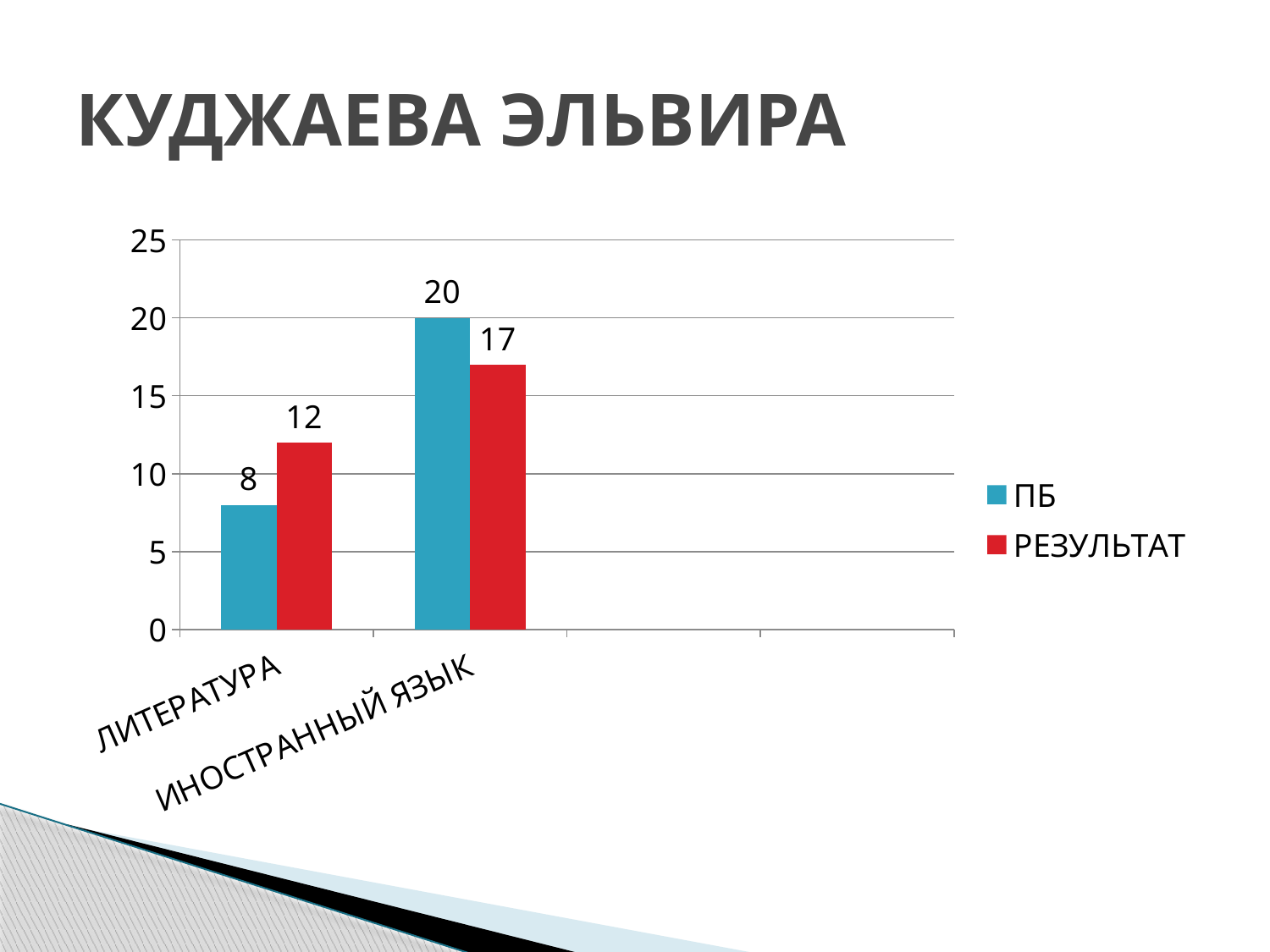
What is the РЕЗУЛЬТАТ value for ЛИТЕРАТУРА? 12 What is the ПБ value for ИНОСТРАННЫЙ ЯЗЫК? 20 How many categories are shown on the x axis? 2 What kind of chart is shown on the slide? Bar chart What is the difference between the ПБ and РЕЗУЛЬТАТ values for ИНОСТРАННЫЙ ЯЗЫК? 3 How many series does the legend list? 2 Which category has the highest ПБ value? ИНОСТРАННЫЙ ЯЗЫК What is the РЕЗУЛЬТАТ value for ИНОСТРАННЫЙ ЯЗЫК? 17 What is the difference between the РЕЗУЛЬТАТ and ПБ values for ЛИТЕРАТУРА? 4 For ЛИТЕРАТУРА, which is larger: ПБ or РЕЗУЛЬТАТ? РЕЗУЛЬТАТ Which category has the lowest РЕЗУЛЬТАТ value? ЛИТЕРАТУРА What is the ПБ value for ЛИТЕРАТУРА? 8